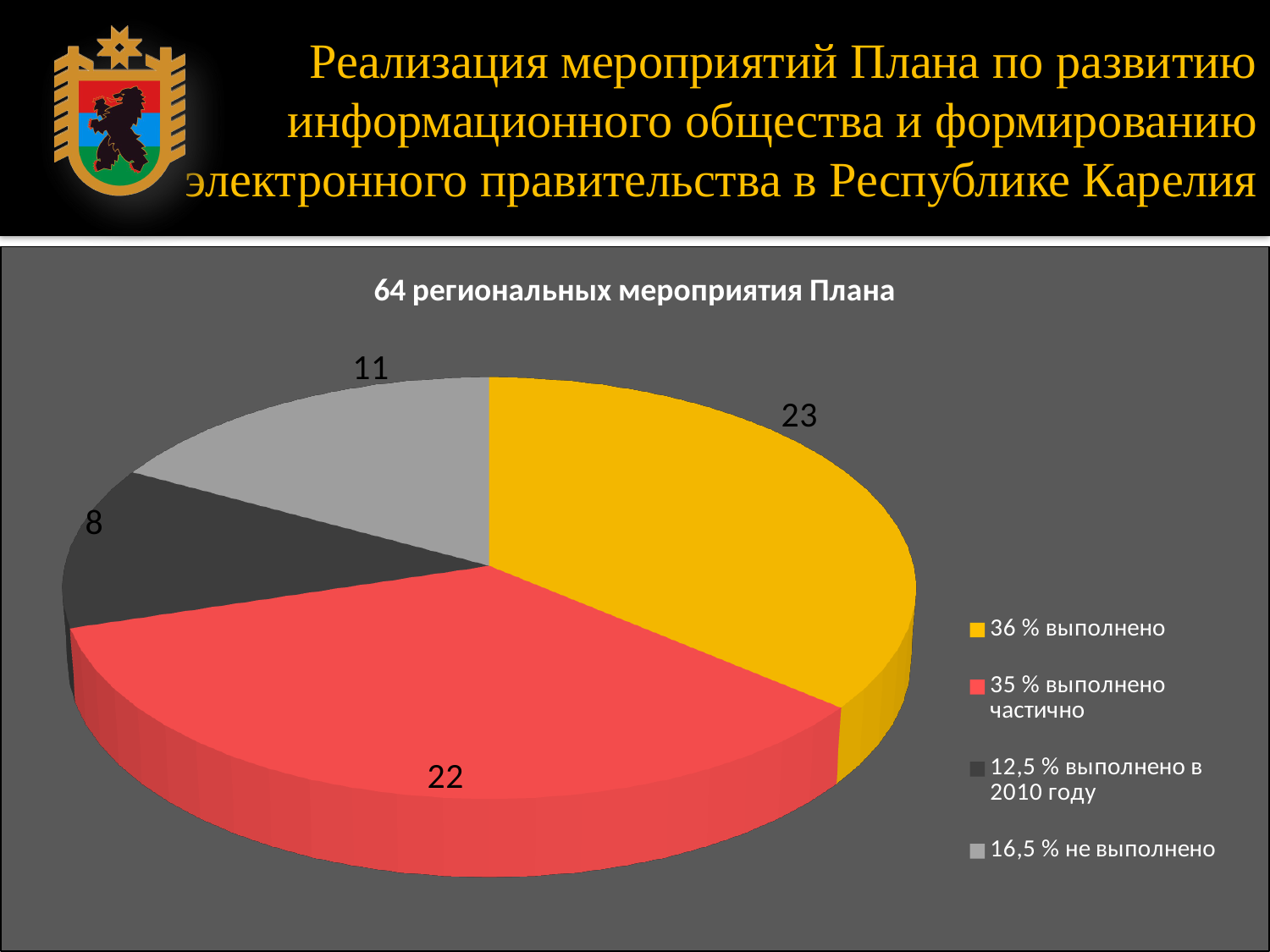
What is the title of the chart? 64 региональных мероприятия Плана What value is shown for the slice labelled "12,5 % выполнено в 2010 году"? 8 Which is larger: the value for "16,5 % не выполнено" or the value for "12,5 % выполнено в 2010 году"? 16,5 % не выполнено What value is shown for the slice labelled "16,5 % не выполнено"? 11 What value is shown for the slice labelled "35 % выполнено частично"? 22 Which slice has the smallest value? 12,5 % выполнено в 2010 году What value is shown for the slice labelled "36 % выполнено"? 23 Which slice has the largest value? 36 % выполнено How many slices does the pie chart have? 4 What type of chart is shown on the slide? pie chart How many entries does the legend list? 4 What is the difference between the values of the "36 % выполнено" slice and the "16,5 % не выполнено" slice? 12